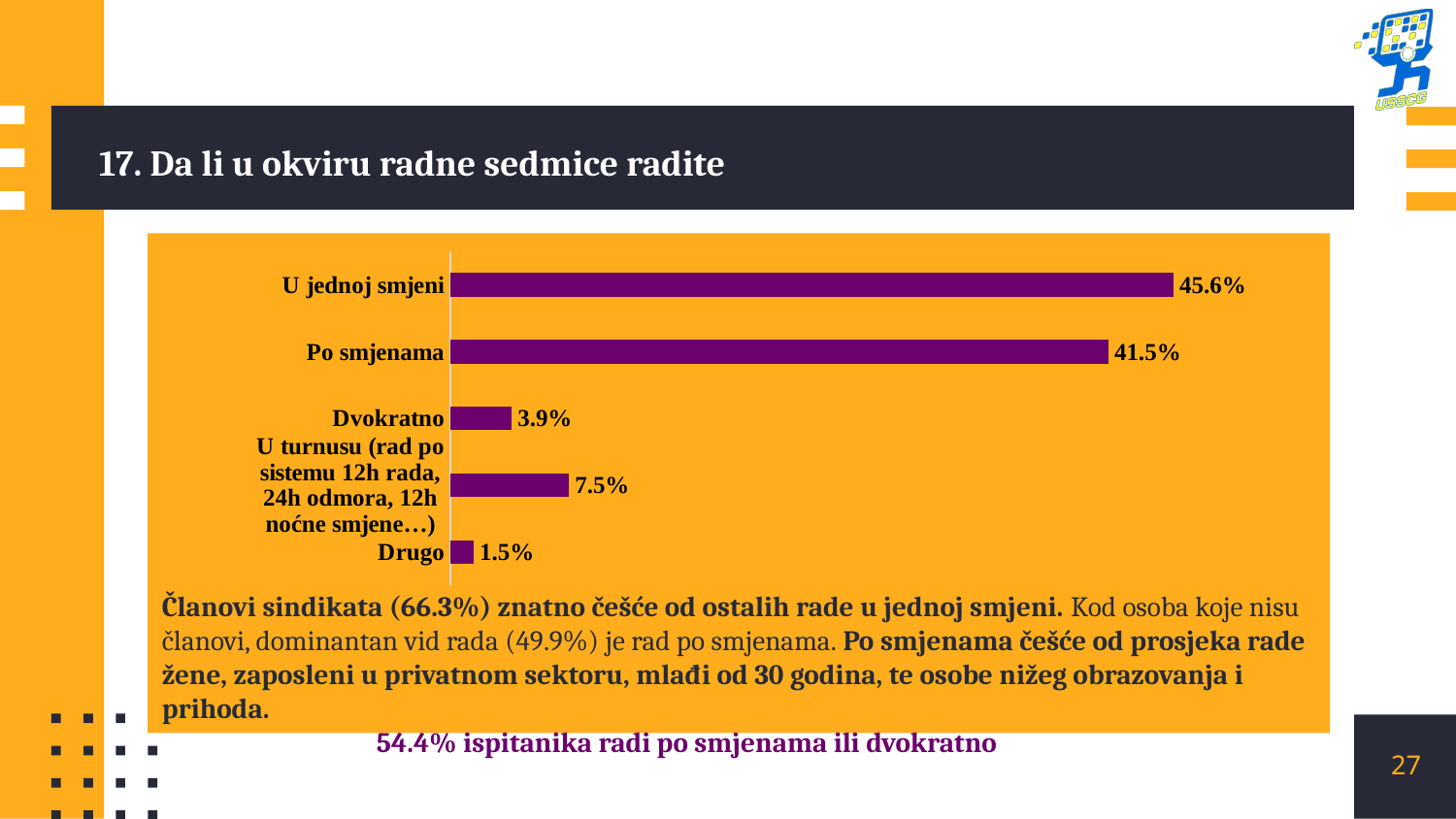
What kind of chart is shown on the slide? Bar chart How many categories are shown in the chart? 5 What is the difference between the values for "U jednoj smjeni" and "Po smjenama"? 4.1% What colour are the bars in the chart? Purple What is the value for "U turnusu (rad po sistemu 12h rada, 24h odmora, 12h noćne smjene…)"? 7.5% What is the value for "Po smjenama"? 41.5% Which is larger, the value for "Dvokratno" or the value for "U turnusu"? U turnusu What is the value for "U jednoj smjeni"? 45.6% Which category has the lowest value? Drugo What is the value for "Dvokratno"? 3.9% Which category has the highest value? U jednoj smjeni What is the value for "Drugo"? 1.5%